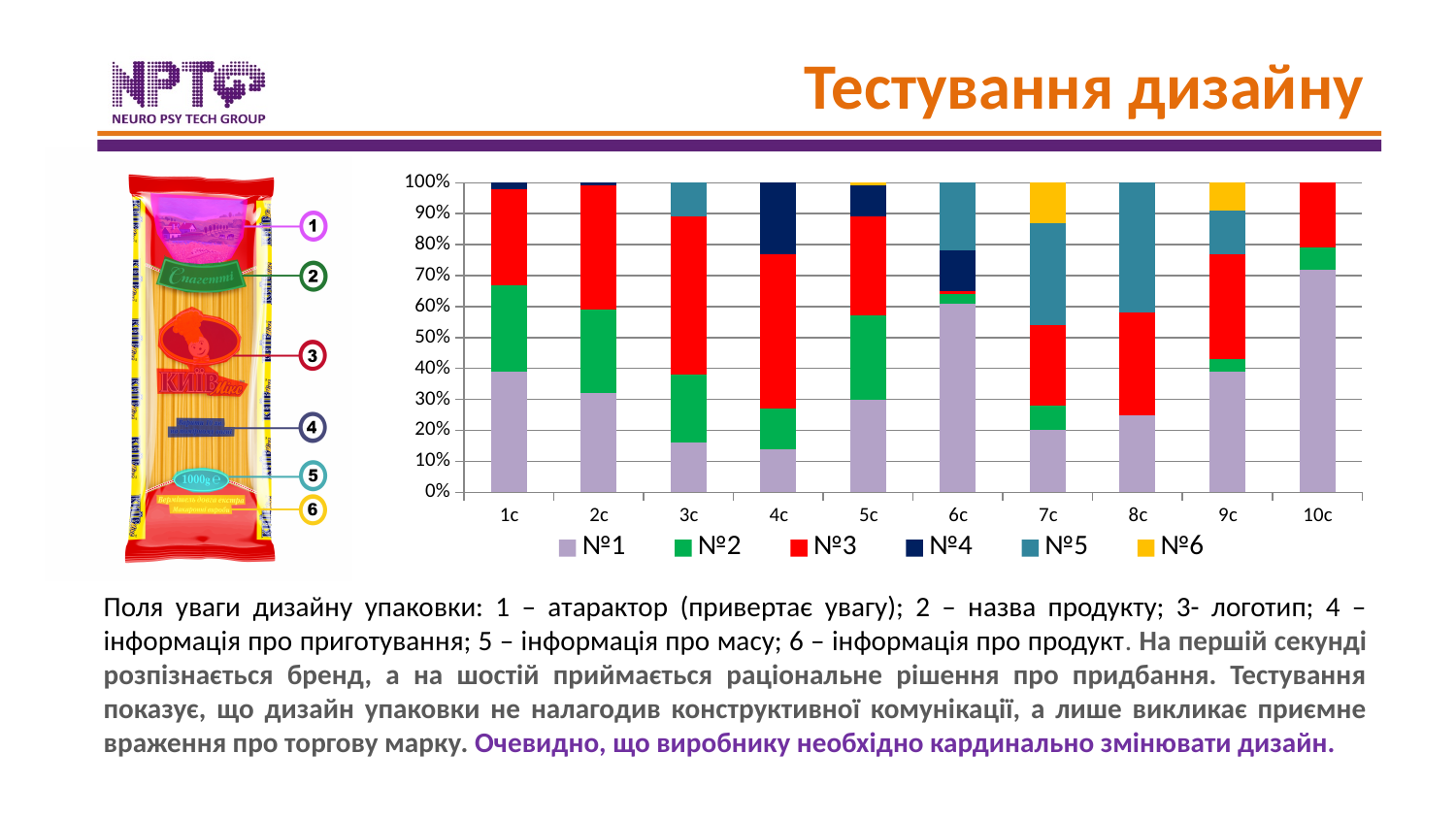
Which has a larger №1 segment, 6c or 8c? 6c Is the value of the №1 segment for 8c greater or less than 30%? less Is the value of the №1 segment for 1c greater or less than 30%? greater What kind of chart is shown on the slide? stacked bar chart Which category has the largest №1 segment? 10c What is the total of the stacked bar for 1c? 100% What colour represents series №3 in the chart? red Is the value of the №1 segment for 2c greater or less than 40%? less How many categories are shown on the x axis of the chart? 10 How many series have a visible segment in the 10c bar? 3 How many series does the chart legend list? 6